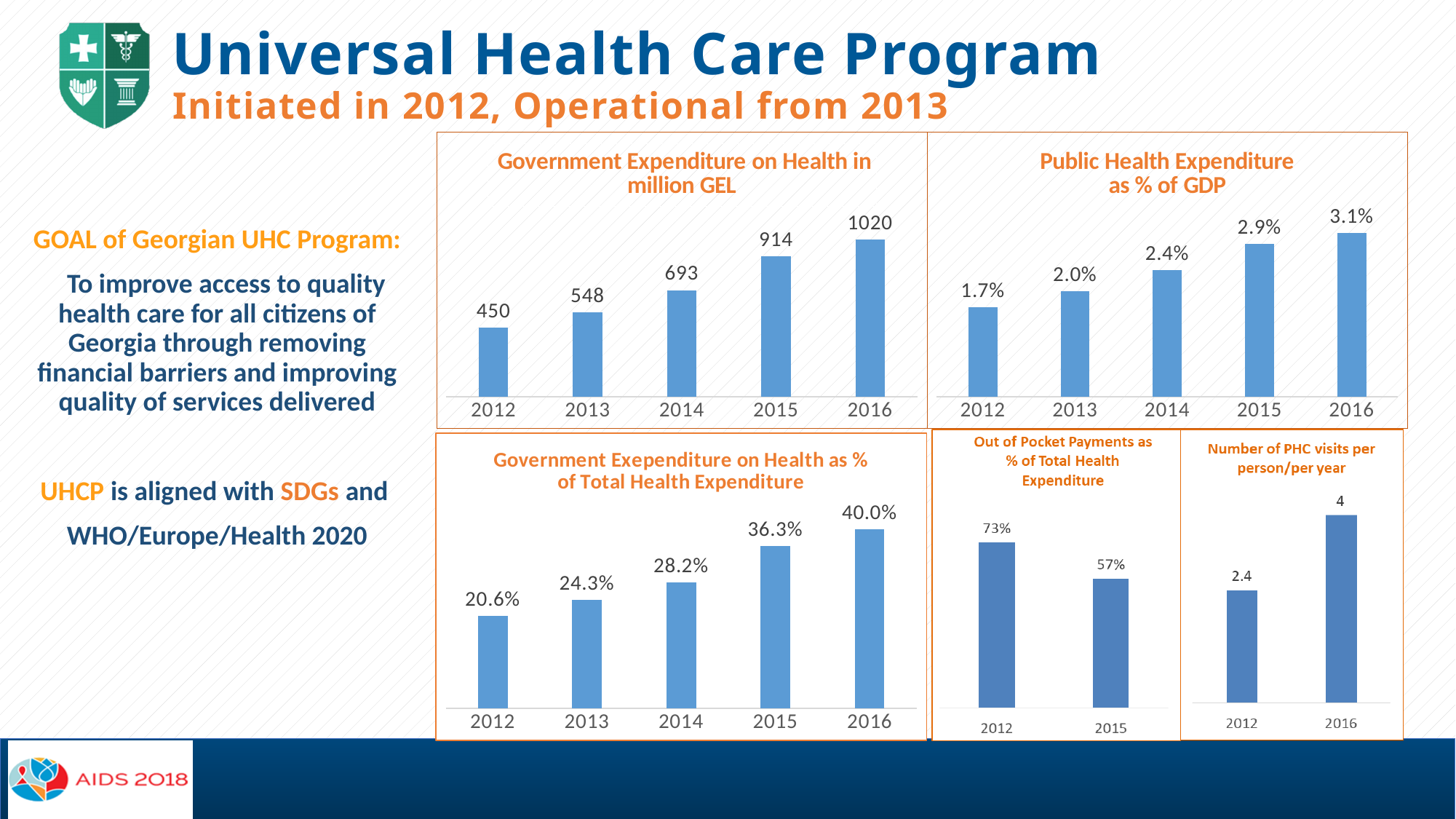
In the 'Out of Pocket Payments as % of Total Health Expenditure' chart, which year has the larger value, 2012 or 2015? 2012 In the 'Public Health Expenditure as % of GDP' chart, do the values rise or fall from 2012 to 2016? rise In the 'Government Exependiture on Health as % of Total Health Expenditure' chart, what is the value for 2015? 36.3% In the 'Government Expenditure on Health in million GEL' chart, what is the value for 2014? 693 In the 'Public Health Expenditure as % of GDP' chart, what is the value for 2013? 2.0% What type of chart is the 'Number of PHC visits per person/per year' chart? bar chart In the 'Public Health Expenditure as % of GDP' chart, which year has the lowest value? 2012 In the 'Government Exependiture on Health as % of Total Health Expenditure' chart, how many years are shown? 5 In the 'Number of PHC visits per person/per year' chart, what is the value for 2012? 2.4 In the 'Government Expenditure on Health in million GEL' chart, which year has the highest value? 2016 In the 'Government Expenditure on Health in million GEL' chart, what is the difference between the 2016 and 2012 values? 570 In the 'Out of Pocket Payments as % of Total Health Expenditure' chart, what is the value for 2015? 57%